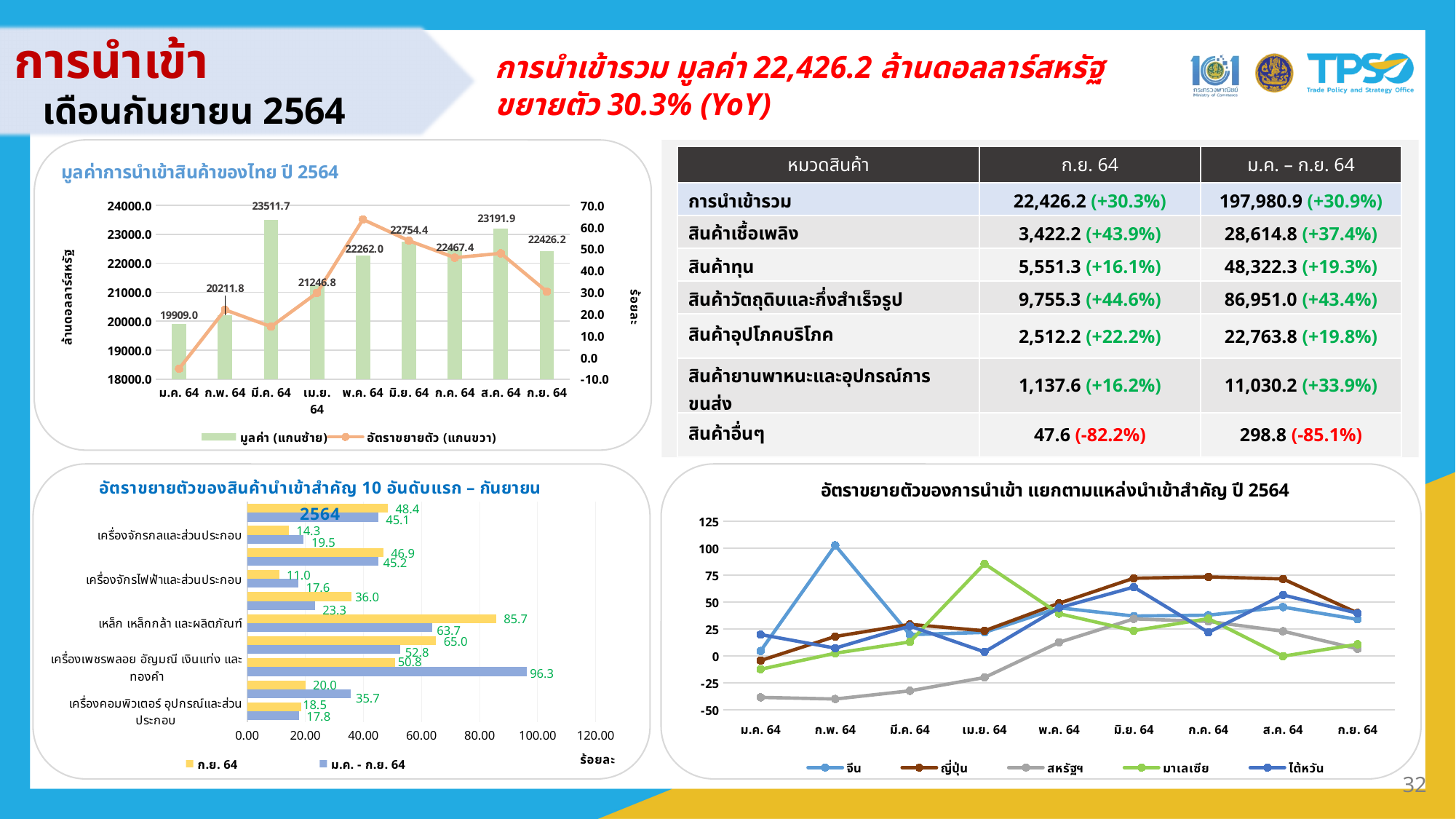
In the chart titled อัตราขยายตัวของสินค้านำเข้าสำคัญ 10 อันดับแรก – กันยายน, what is the ม.ค. - ก.ย. 64 value for เครื่องเพชรพลอย อัญมณี เงินแท่ง และทองคำ? 96.3 In the chart titled อัตราขยายตัวของสินค้านำเข้าสำคัญ 10 อันดับแรก – กันยายน, what is the ก.ย. 64 value for เหล็ก เหล็กกล้า และผลิตภัณฑ์? 85.7 In the chart titled อัตราขยายตัวของการนำเข้า แยกตามแหล่งนำเข้าสำคัญ ปี 2564, is the value for สหรัฐฯ in ม.ค. 64 greater or less than -25? less What kind of chart is the one titled อัตราขยายตัวของสินค้านำเข้าสำคัญ 10 อันดับแรก – กันยายน? bar chart In the chart titled มูลค่าการนำเข้าสินค้าของไทย ปี 2564, what is the import value for มี.ค. 64? 23511.7 In the chart titled มูลค่าการนำเข้าสินค้าของไทย ปี 2564, which month has the highest import value bar? มี.ค. 64 In the chart titled มูลค่าการนำเข้าสินค้าของไทย ปี 2564, which month has the lowest import value bar? ม.ค. 64 In the chart titled มูลค่าการนำเข้าสินค้าของไทย ปี 2564, how many months are shown on the x axis? 9 In the chart titled มูลค่าการนำเข้าสินค้าของไทย ปี 2564, how many series does the legend list? 2 In the chart titled อัตราขยายตัวของสินค้านำเข้าสำคัญ 10 อันดับแรก – กันยายน, which is larger for เครื่องคอมพิวเตอร์ อุปกรณ์และส่วนประกอบ: the ก.ย. 64 value or the ม.ค. - ก.ย. 64 value? ก.ย. 64 In the chart titled มูลค่าการนำเข้าสินค้าของไทย ปี 2564, what is the difference between the import values for มี.ค. 64 and ม.ค. 64? 3602.7 In the chart titled อัตราขยายตัวของการนำเข้า แยกตามแหล่งนำเข้าสำคัญ ปี 2564, which source has the highest value in ก.พ. 64? จีน